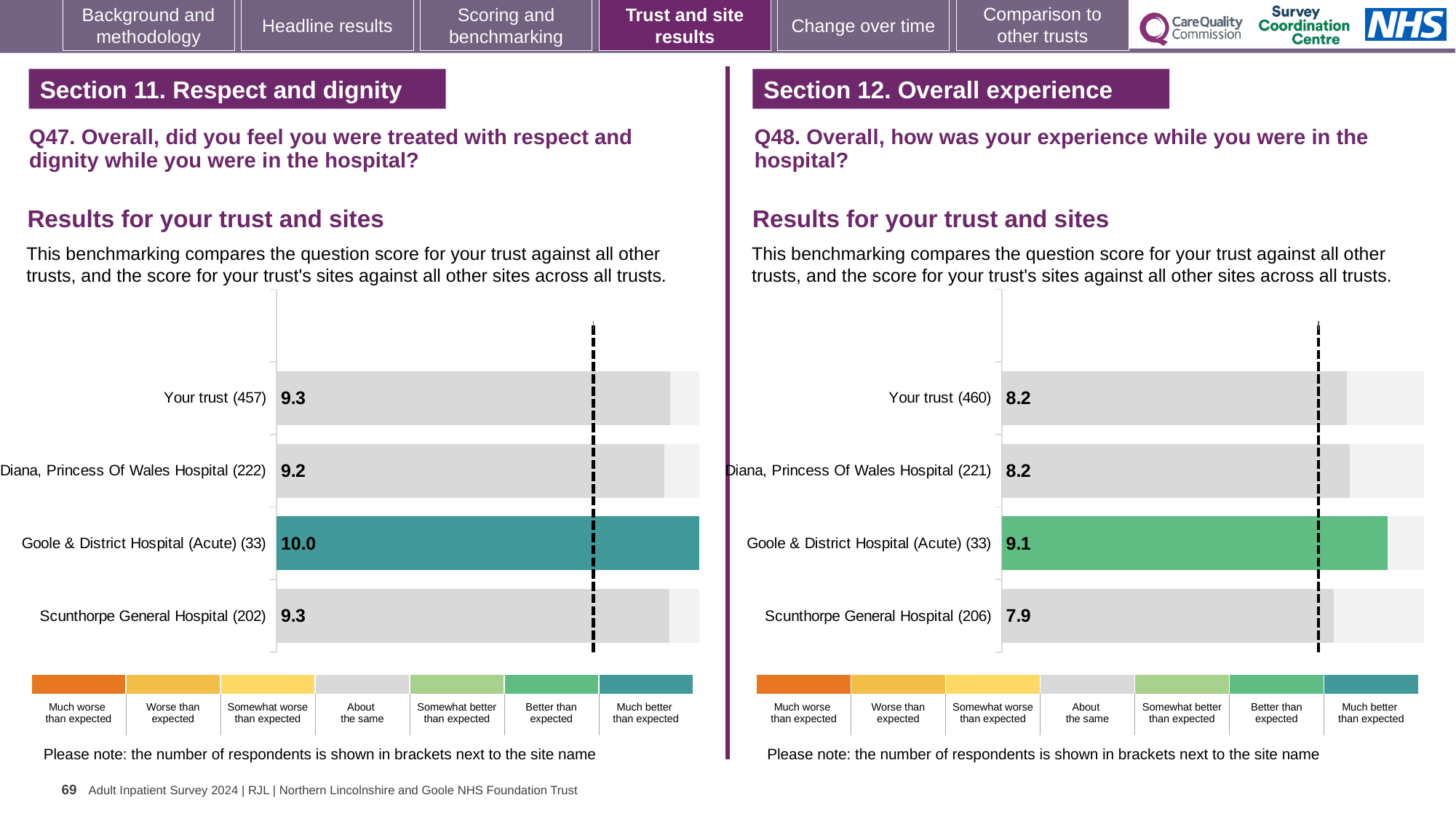
On the Q47 chart (left), how many bars are plotted? 4 On the Q47 chart (left), what is the score for Diana, Princess Of Wales Hospital? 9.2 On the Q48 chart (right), what is the score for Your trust? 8.2 On the Q47 chart (left), what is the score for Goole & District Hospital (Acute)? 10.0 On the Q47 chart (left), which site has the highest score? Goole & District Hospital (Acute) On the Q48 chart (right), which site has the highest score? Goole & District Hospital (Acute) On the Q48 chart (right), what is the score for Scunthorpe General Hospital? 7.9 What type of chart is used on the Q47 chart (left)? Bar chart On the Q48 chart (right), which is larger: the score for Your trust or the score for Scunthorpe General Hospital? Your trust On the Q47 chart (left), what is the difference between the scores for Goole & District Hospital (Acute) and Diana, Princess Of Wales Hospital? 0.8 On the Q48 chart (right), which site has the lowest score? Scunthorpe General Hospital On the Q48 chart (right), what is the difference between the scores for Goole & District Hospital (Acute) and Scunthorpe General Hospital? 1.2